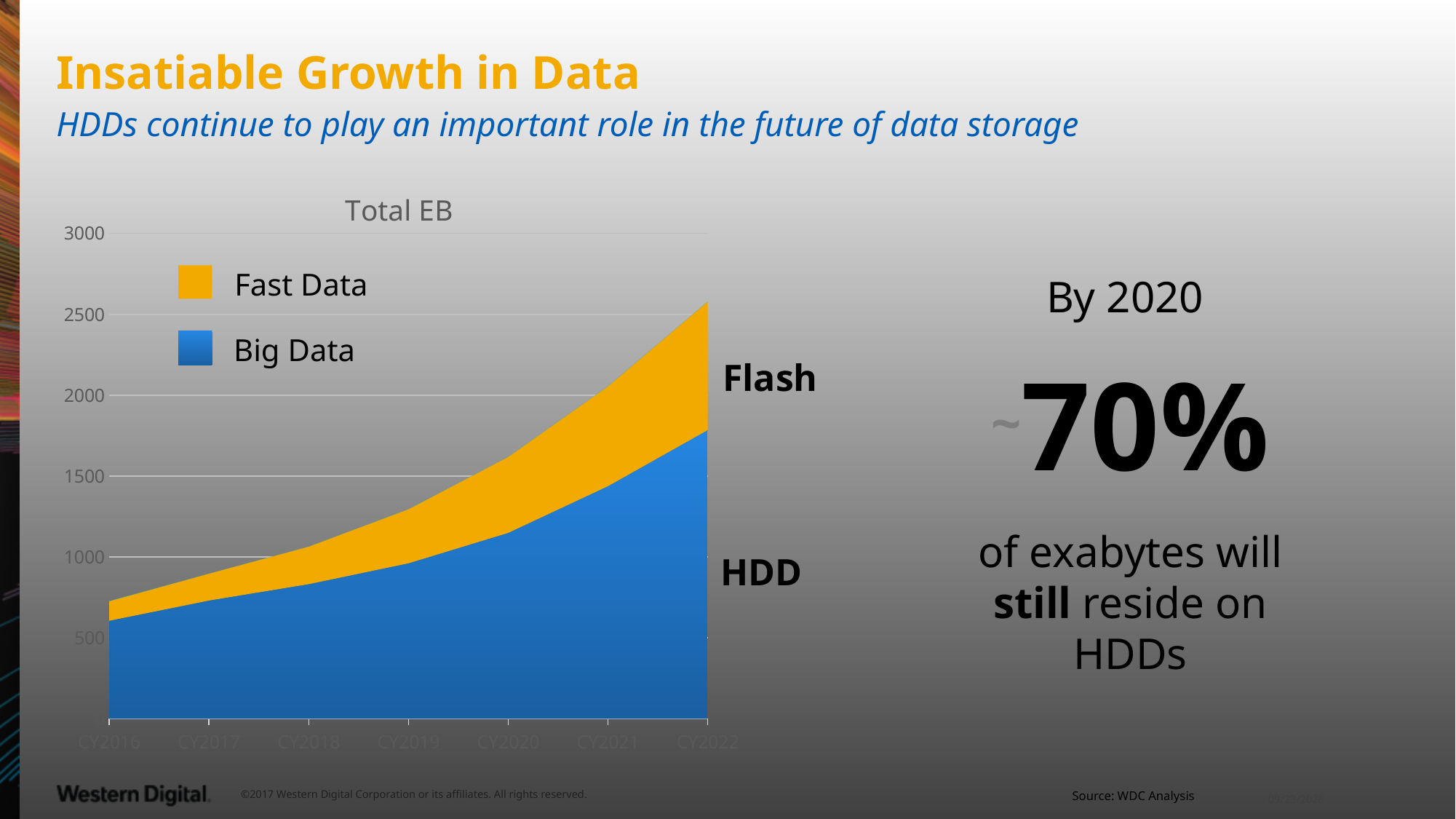
How many years are shown along the x axis of the chart? 7 Is the total EB for CY2022 greater or less than 2000? greater Which year has the lowest total EB in the chart? CY2016 Which year has the highest total EB in the chart? CY2022 What kind of chart is shown on the slide? Area chart Is the Big Data value for CY2022 greater or less than 1500? greater Which two series are listed in the chart legend? Fast Data and Big Data Do the total exabytes rise or fall from CY2016 to CY2022? Rise Is the total EB for CY2016 greater or less than 1000? less How many series does the chart legend list? 2 In CY2022, which series is larger, Big Data or Fast Data? Big Data What is the title of the chart? Total EB